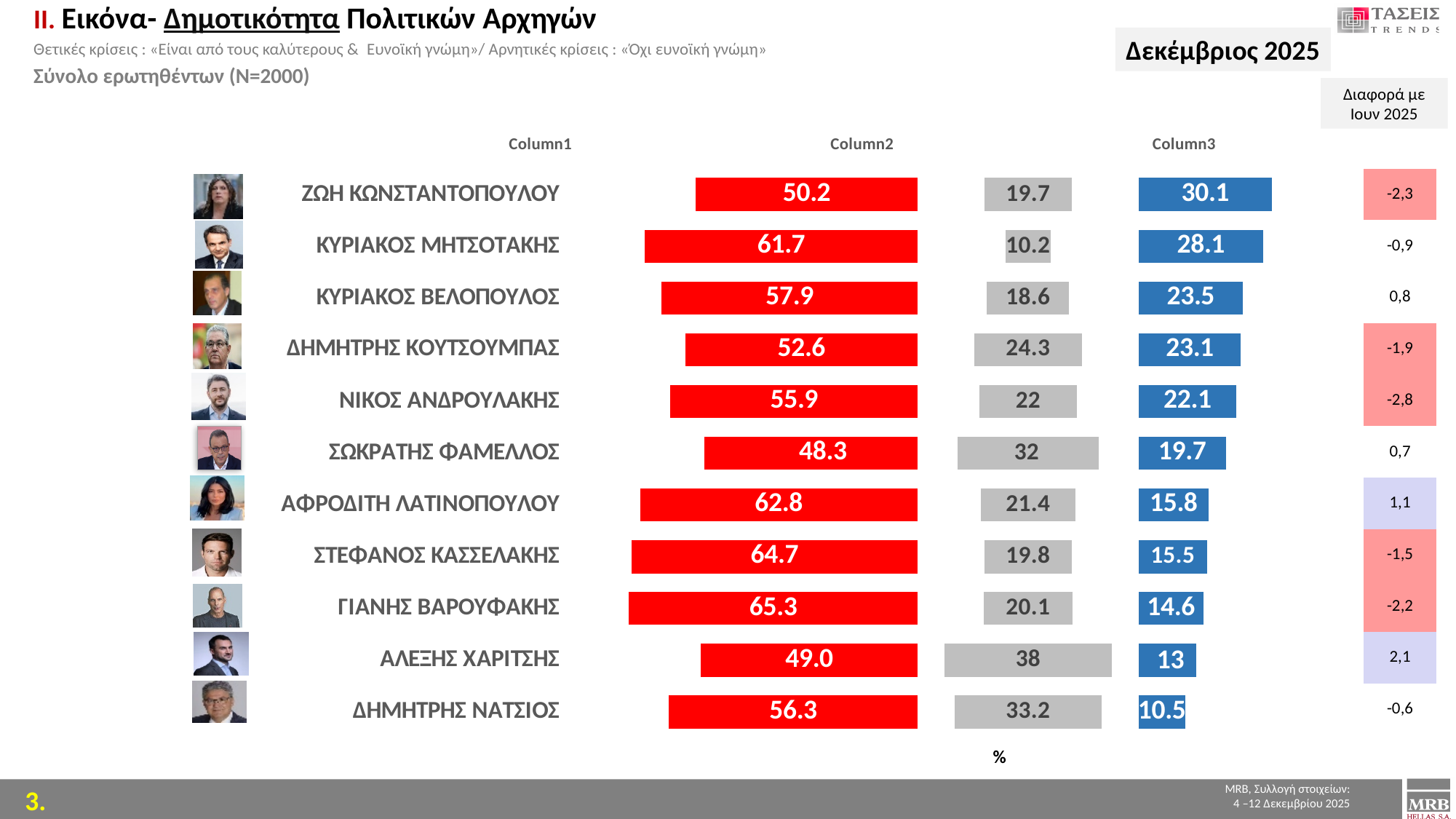
What is the Column1 value for ΚΥΡΙΑΚΟΣ ΜΗΤΣΟΤΑΚΗΣ? 61.7 Which person has the highest Column1 value? ΓΙΑΝΗΣ ΒΑΡΟΥΦΑΚΗΣ Who has the larger Column1 value, ΣΤΕΦΑΝΟΣ ΚΑΣΣΕΛΑΚΗΣ or ΑΦΡΟΔΙΤΗ ΛΑΤΙΝΟΠΟΥΛΟΥ? ΣΤΕΦΑΝΟΣ ΚΑΣΣΕΛΑΚΗΣ What is the total of the stacked bar for ΚΥΡΙΑΚΟΣ ΒΕΛΟΠΟΥΛΟΣ? 100 What kind of chart is shown on the slide? Stacked bar chart How many series does the chart show? 3 How many people are shown in the chart? 11 What is the Column2 value for ΑΛΕΞΗΣ ΧΑΡΙΤΣΗΣ? 38 Which person has the lowest Column1 value? ΣΩΚΡΑΤΗΣ ΦΑΜΕΛΛΟΣ What is the difference between the Column1 values of ΚΥΡΙΑΚΟΣ ΜΗΤΣΟΤΑΚΗΣ and ΖΩΗ ΚΩΝΣΤΑΝΤΟΠΟΥΛΟΥ? 11.5 Which person has the lowest Column3 value? ΔΗΜΗΤΡΗΣ ΝΑΤΣΙΟΣ What is the Column3 value for ΖΩΗ ΚΩΝΣΤΑΝΤΟΠΟΥΛΟΥ? 30.1